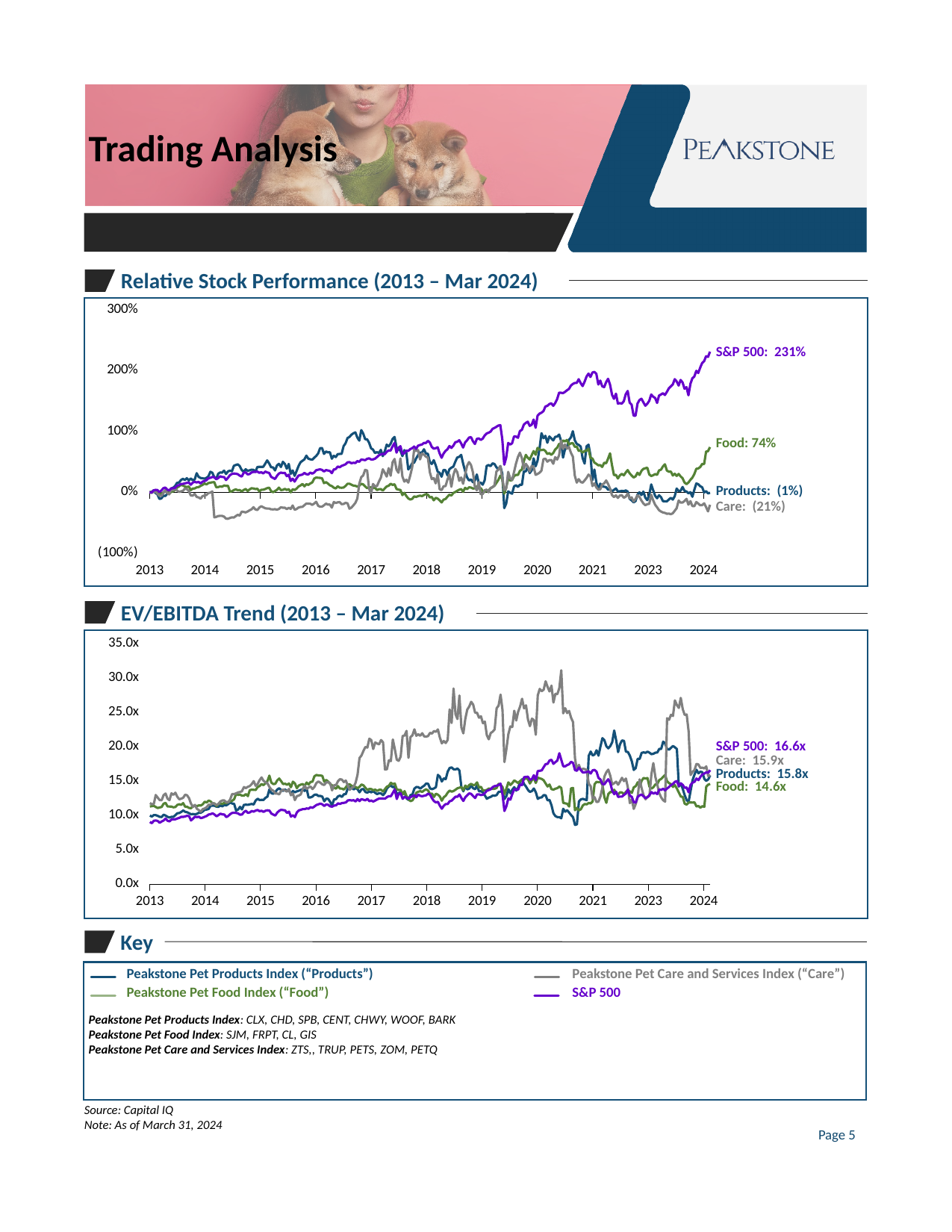
How many series are plotted in the Relative Stock Performance chart? 4 In the EV/EBITDA Trend chart, what is the ending value labelled for Food? 14.6x In the Relative Stock Performance chart, which series has the lowest labelled ending value? Care In the Relative Stock Performance chart, what is the ending value labelled for Food? 74% In the EV/EBITDA Trend chart, is the labelled ending value for the S&P 500 or for Food larger? S&P 500 What kind of chart is the EV/EBITDA Trend chart? Line chart In the Relative Stock Performance chart, what is the difference between the labelled ending values for the S&P 500 and Food? 157% In the EV/EBITDA Trend chart, which series has the highest labelled ending value? S&P 500 In the Relative Stock Performance chart, what is the ending value labelled for Care? (21%) In the EV/EBITDA Trend chart, what is the ending value labelled for Products? 15.8x In the Relative Stock Performance chart, what is the ending value labelled for the S&P 500? 231% In the Relative Stock Performance chart, which series has the highest labelled ending value? S&P 500